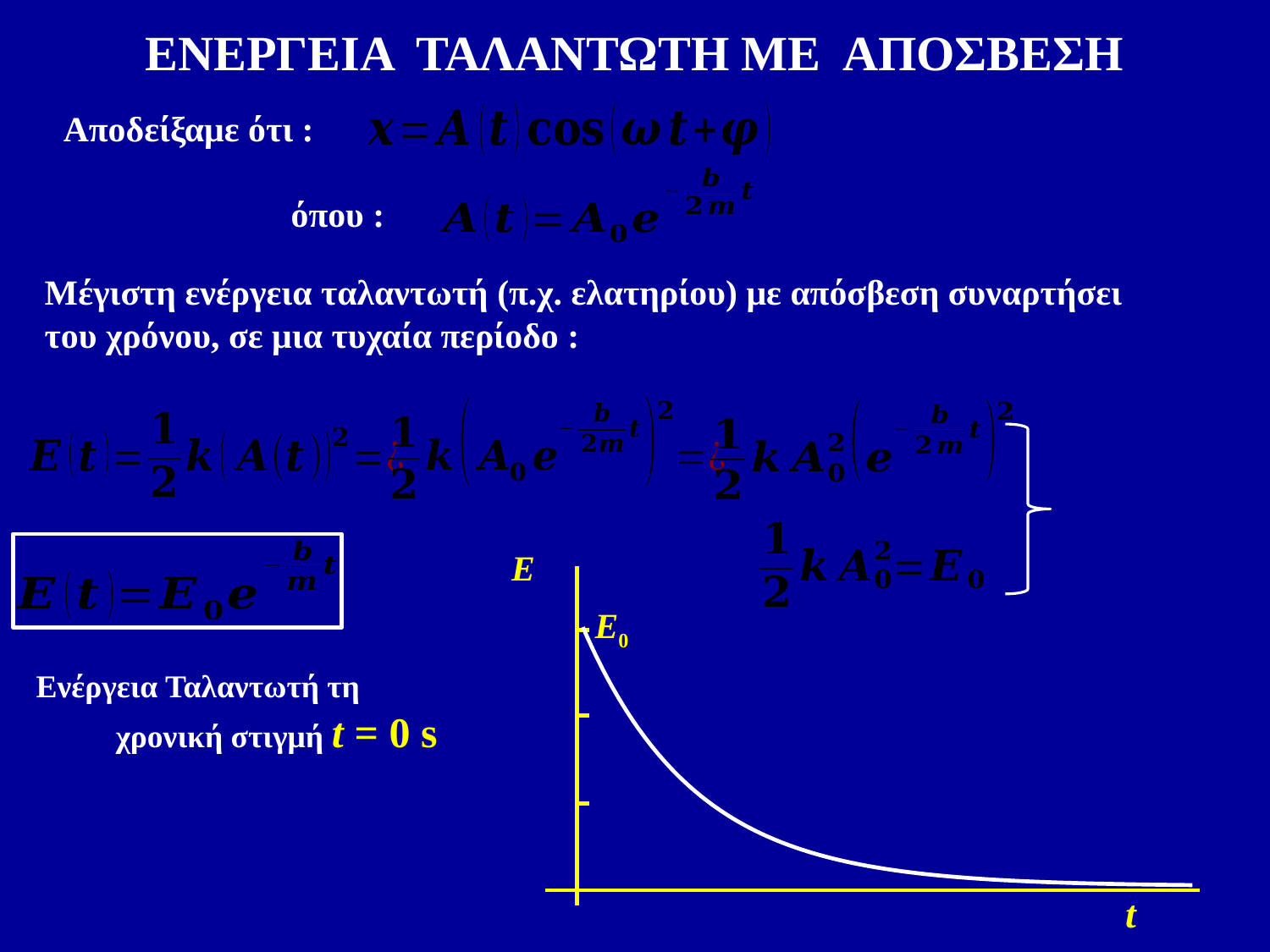
In the chart of E versus t, does the value of E rise or fall as t increases? fall How many curves are plotted on the chart? 1 What label is on the horizontal axis of the chart? t On the chart, is the value of E at the start of the curve larger or smaller than at the far right end? larger What kind of chart is shown at the bottom right of the slide? line chart What label marks the starting value of the curve at t = 0 on the chart? E0 What label is on the vertical axis of the chart? E